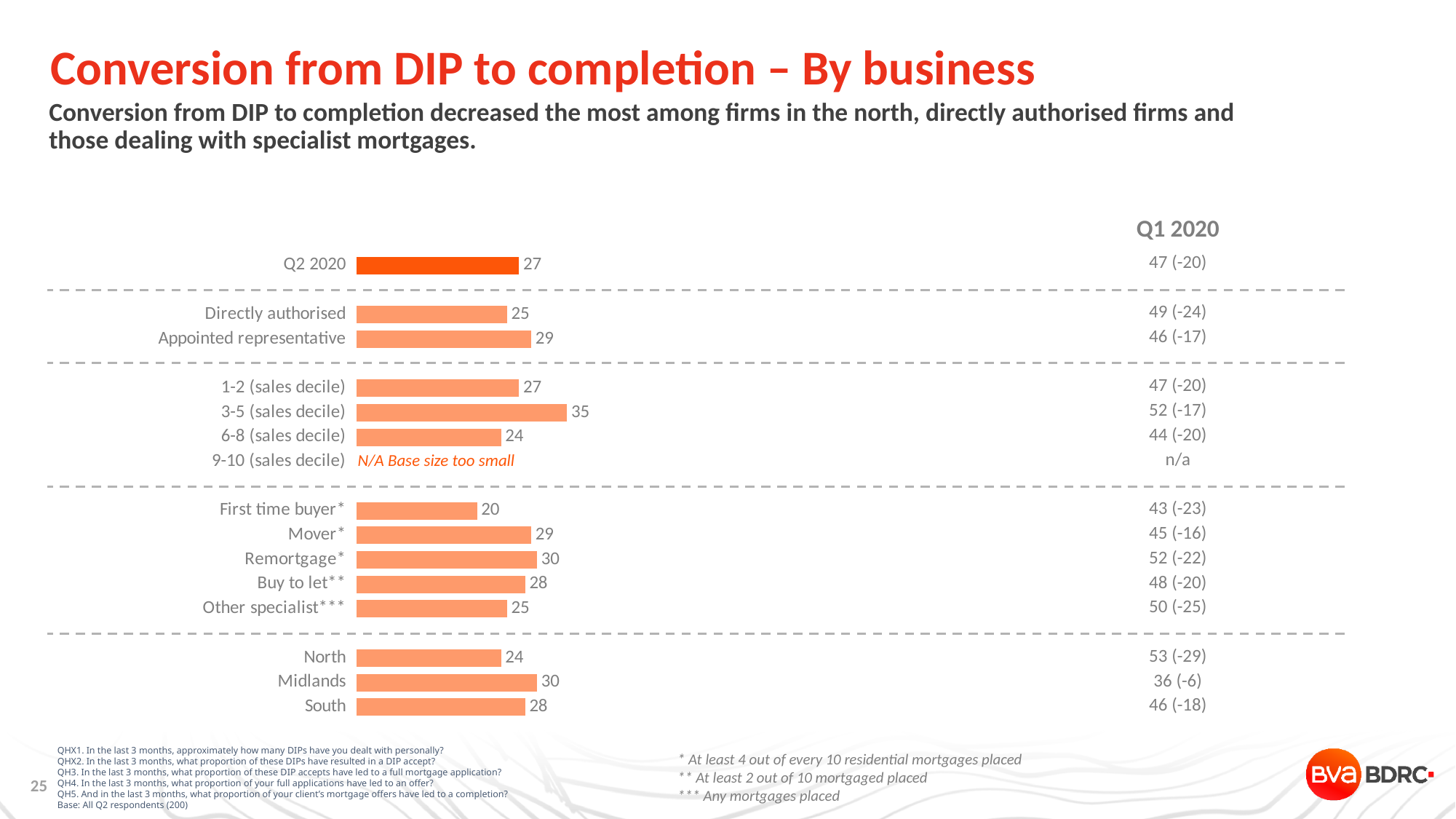
What is the value for Midlands? 30 What is the value for Q2 2020 overall? 27 What kind of chart is shown on the slide? Bar chart Which category has the lowest value in the chart? First time buyer Which has a larger value, North or South? South What is the value for First time buyer? 20 What is shown in place of a bar for 9-10 (sales decile)? N/A Base size too small What is the value for Directly authorised? 25 What is the difference between the values for Appointed representative and Directly authorised? 4 How many bars are plotted in the chart? 14 What is the value for 3-5 (sales decile)? 35 Which category has the highest value in the chart? 3-5 (sales decile)